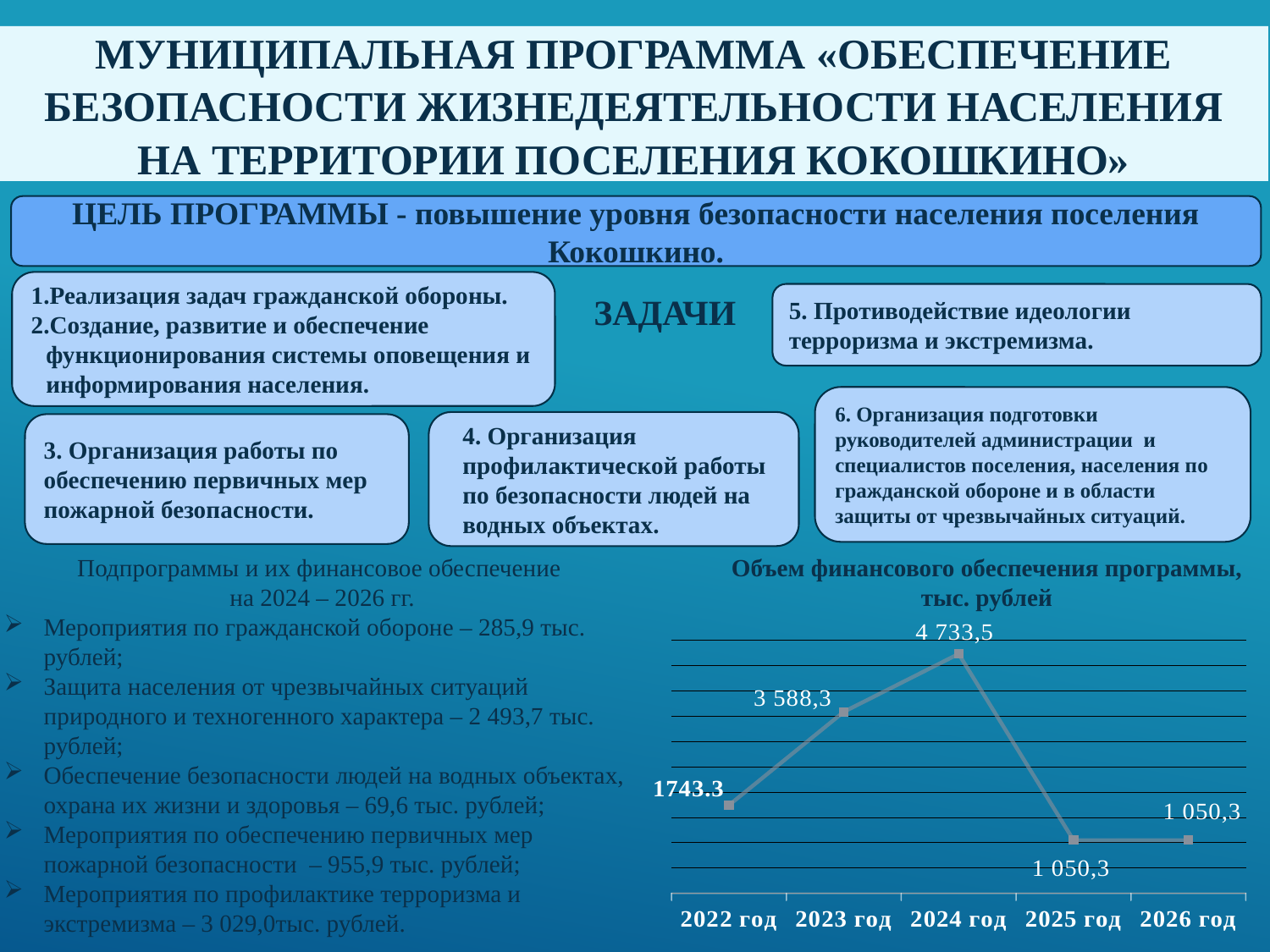
What is the value for 2024 год in the chart? 4 733,5 What is the value for 2025 год in the chart? 1 050,3 What is the title of the chart on the slide? Объем финансового обеспечения программы, тыс. рублей What is the value for 2022 год in the chart? 1743.3 Does the value rise or fall from 2024 год to 2025 год in the chart? fall Which is larger in the chart, the value for 2023 год or the value for 2022 год? 2023 год Which year has the highest value in the chart? 2024 год What is the difference between the values for 2024 год and 2023 год in the chart? 1 145,2 What is the value for 2023 год in the chart? 3 588,3 How many years are plotted on the x axis of the chart? 5 What is the difference between the values for 2024 год and 2025 год in the chart? 3 683,2 What type of chart is shown on the slide? line chart